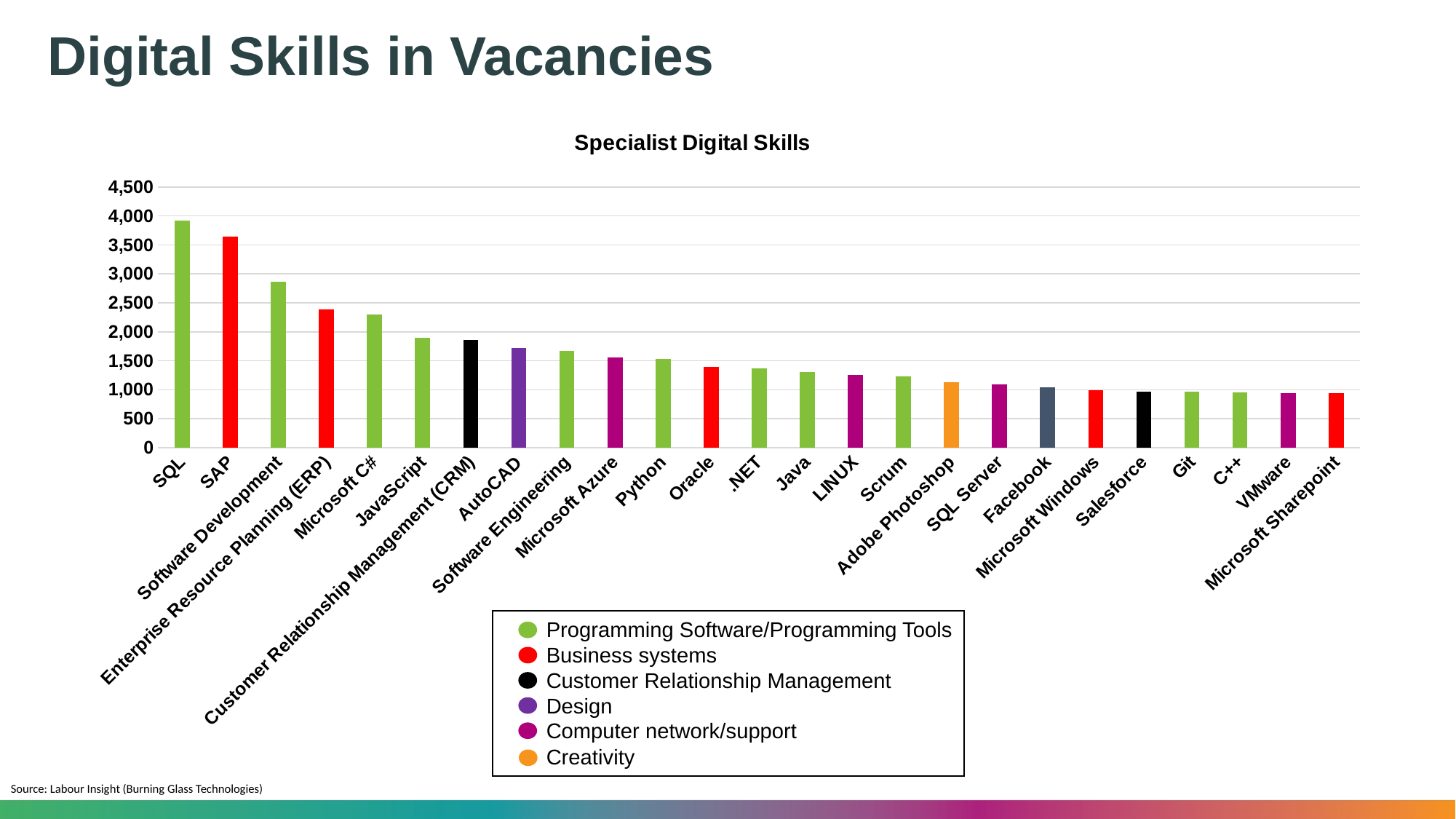
How many categories does the legend list? 6 Do the values rise or fall moving from left to right along the x axis? fall Which skill has the highest number of vacancies in the Specialist Digital Skills chart? SQL Is the value for AutoCAD greater or less than 1,500? greater What kind of chart is shown on the slide? bar chart Is the value for JavaScript greater or less than 2,000? less Which has more vacancies, SQL or SAP? SQL Is the value for Enterprise Resource Planning (ERP) greater or less than 2,500? less How many skills are plotted along the x axis of the chart? 25 Which legend category is shown in orange? Creativity